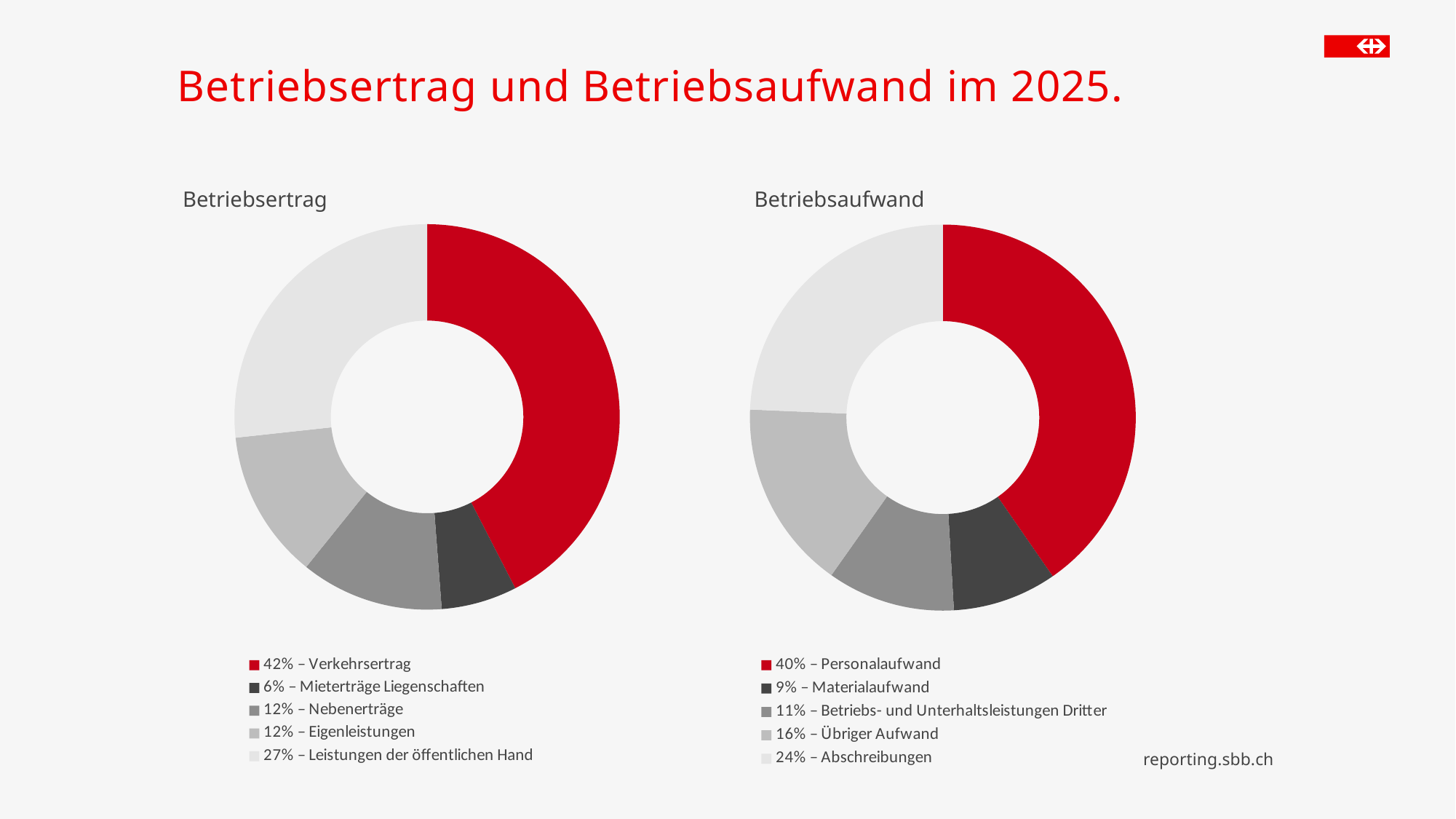
In the Betriebsertrag chart, what is the difference between Verkehrsertrag and Leistungen der öffentlichen Hand? 15% What kind of chart is the Betriebsaufwand chart? Doughnut (pie) chart In the Betriebsaufwand chart, which category has the smallest share? Materialaufwand In the Betriebsertrag chart, what share is Verkehrsertrag? 42% How many categories does the Betriebsertrag chart show? 5 In the Betriebsaufwand chart, which category has the largest share? Personalaufwand In the Betriebsaufwand chart, what share is Personalaufwand? 40% In the Betriebsaufwand chart, what share is Übriger Aufwand? 16% In the Betriebsaufwand chart, what is the difference between Abschreibungen and Übriger Aufwand? 8% In the Betriebsertrag chart, what share is Leistungen der öffentlichen Hand? 27% In the Betriebsertrag chart, which category has the smallest share? Mieterträge Liegenschaften In the Betriebsaufwand chart, which is larger: Materialaufwand or Betriebs- und Unterhaltsleistungen Dritter? Betriebs- und Unterhaltsleistungen Dritter